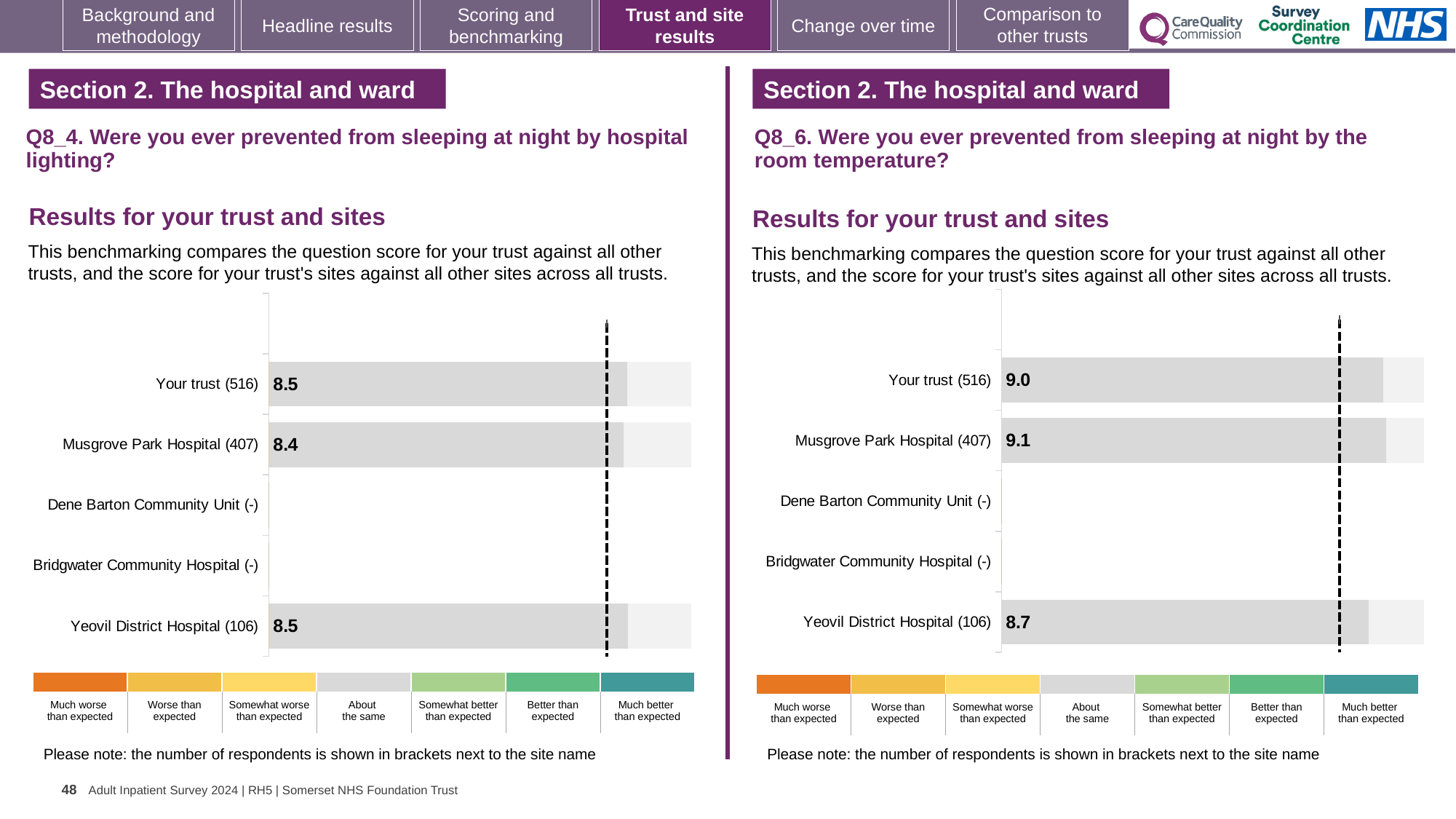
How many sites or trusts are listed on the Q8_4 hospital lighting chart? 5 On the Q8_6 room temperature chart, what is the score for Yeovil District Hospital? 8.7 On the Q8_6 room temperature chart, which site or trust has the highest score? Musgrove Park Hospital On the Q8_4 hospital lighting chart, what is the difference between the Your trust score and the Musgrove Park Hospital score? 0.1 On the Q8_6 room temperature chart, which site or trust has the lowest score? Yeovil District Hospital On the Q8_4 hospital lighting chart, what is the score for Musgrove Park Hospital? 8.4 What kind of chart is the Q8_6 room temperature chart? Bar chart On the Q8_6 room temperature chart, which is larger: the score for Your trust or the score for Yeovil District Hospital? Your trust On the Q8_6 room temperature chart, what is the score for Musgrove Park Hospital? 9.1 On the Q8_4 hospital lighting chart, how many respondents are shown in brackets for Yeovil District Hospital? 106 On the Q8_4 hospital lighting chart, what is the score for Your trust? 8.5 On the Q8_6 room temperature chart, what is the difference between the Musgrove Park Hospital score and the Yeovil District Hospital score? 0.4